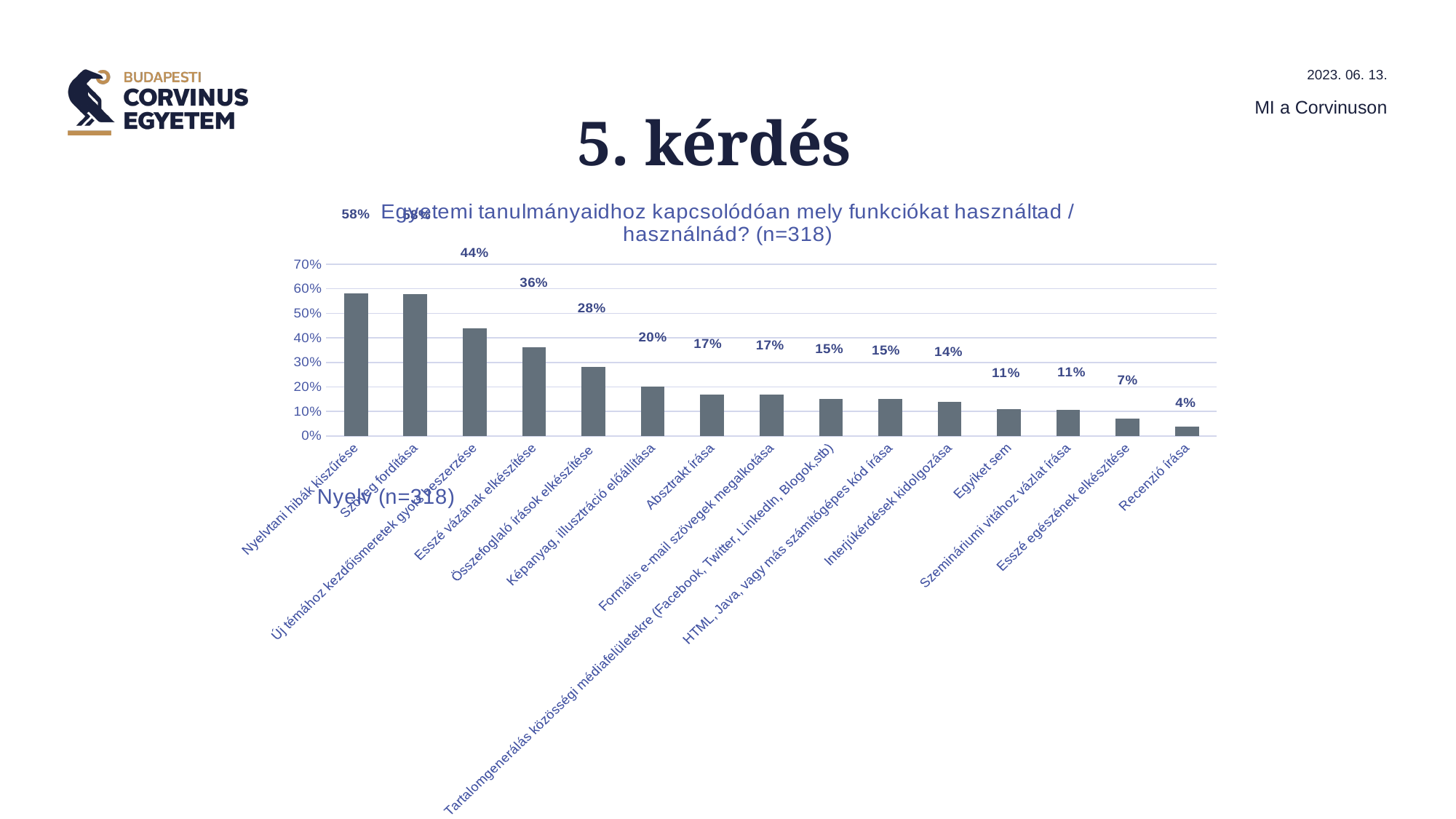
Which is larger, the value for "Esszé vázának elkészítése" or for "Esszé egészének elkészítése"? Esszé vázának elkészítése Is the value for "Absztrakt írása" greater or less than 10%? greater How many categories are plotted in the chart? 15 Do the values rise or fall from left to right along the x axis? fall What is the value for "Interjúkérdések kidolgozása"? 14% Which category has the lowest value? Recenzió írása What is the value for "Recenzió írása"? 4% What is the difference between the values for "Esszé vázának elkészítése" and "Összefoglaló írások elkészítése"? 8 percentage points What kind of chart is shown on the slide? bar chart What is the value for "Egyiket sem"? 11% What is the value for "Esszé vázának elkészítése"? 36% What is the difference between the values for "Nyelvtani hibák kiszűrése" and "Recenzió írása"? 54 percentage points